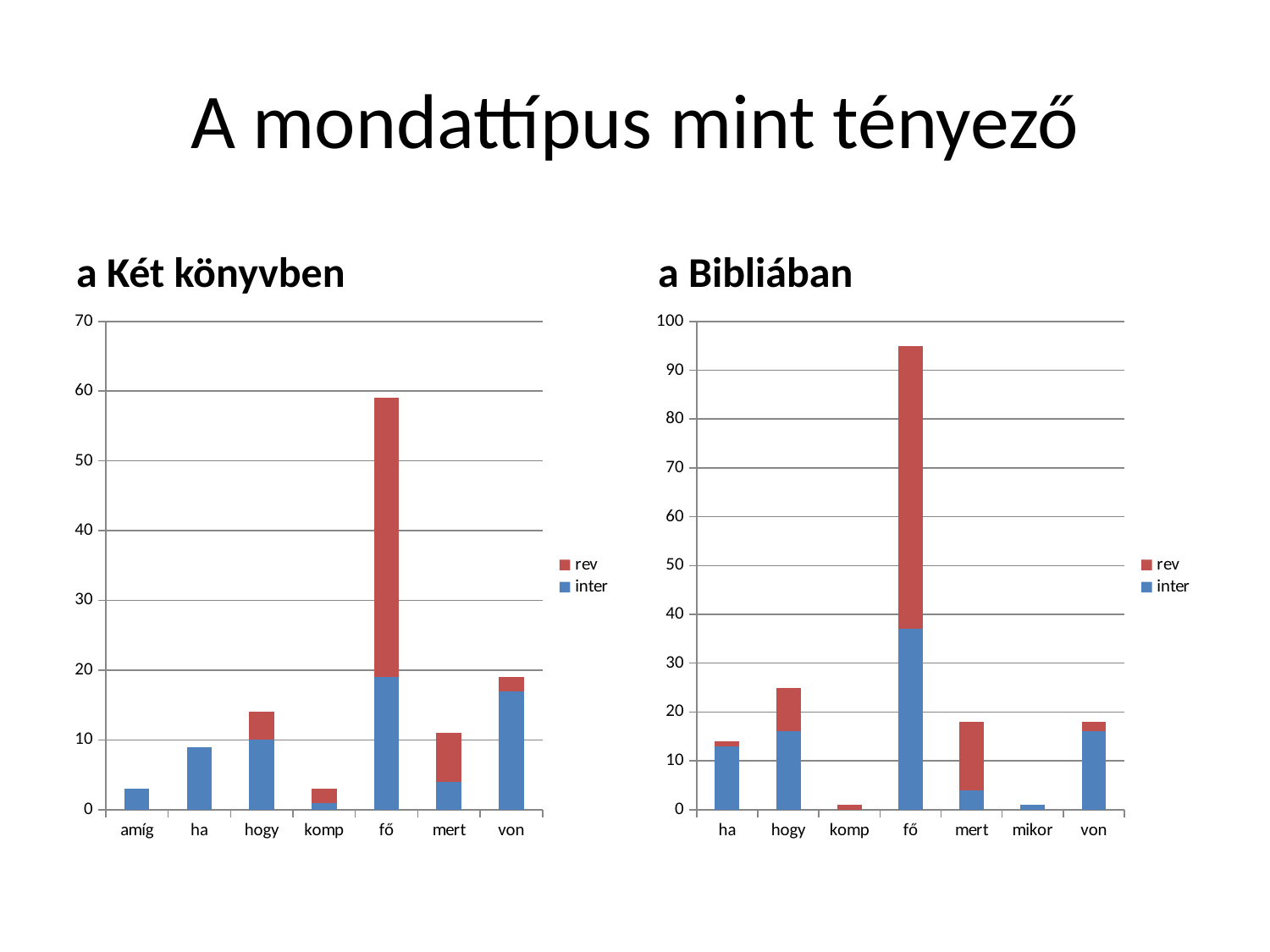
In the chart titled "a Két könyvben", is the total value for fő greater or less than 50? greater How many categories are shown on the x axis of the chart titled "a Bibliában"? 7 In the chart titled "a Bibliában", which category has the tallest bar? fő In the chart titled "a Bibliában", is the total value for mert greater or less than 20? less In the chart titled "a Bibliában", which has the taller bar, hogy or mert? hogy In the chart titled "a Bibliában", is the total value for fő greater or less than 90? greater In the chart titled "a Két könyvben", which has the taller bar, von or mert? von How many series does the legend of the chart titled "a Két könyvben" list? 2 In the chart titled "a Két könyvben", which category has the tallest bar? fő What kind of chart is the chart titled "a Két könyvben"? stacked bar chart